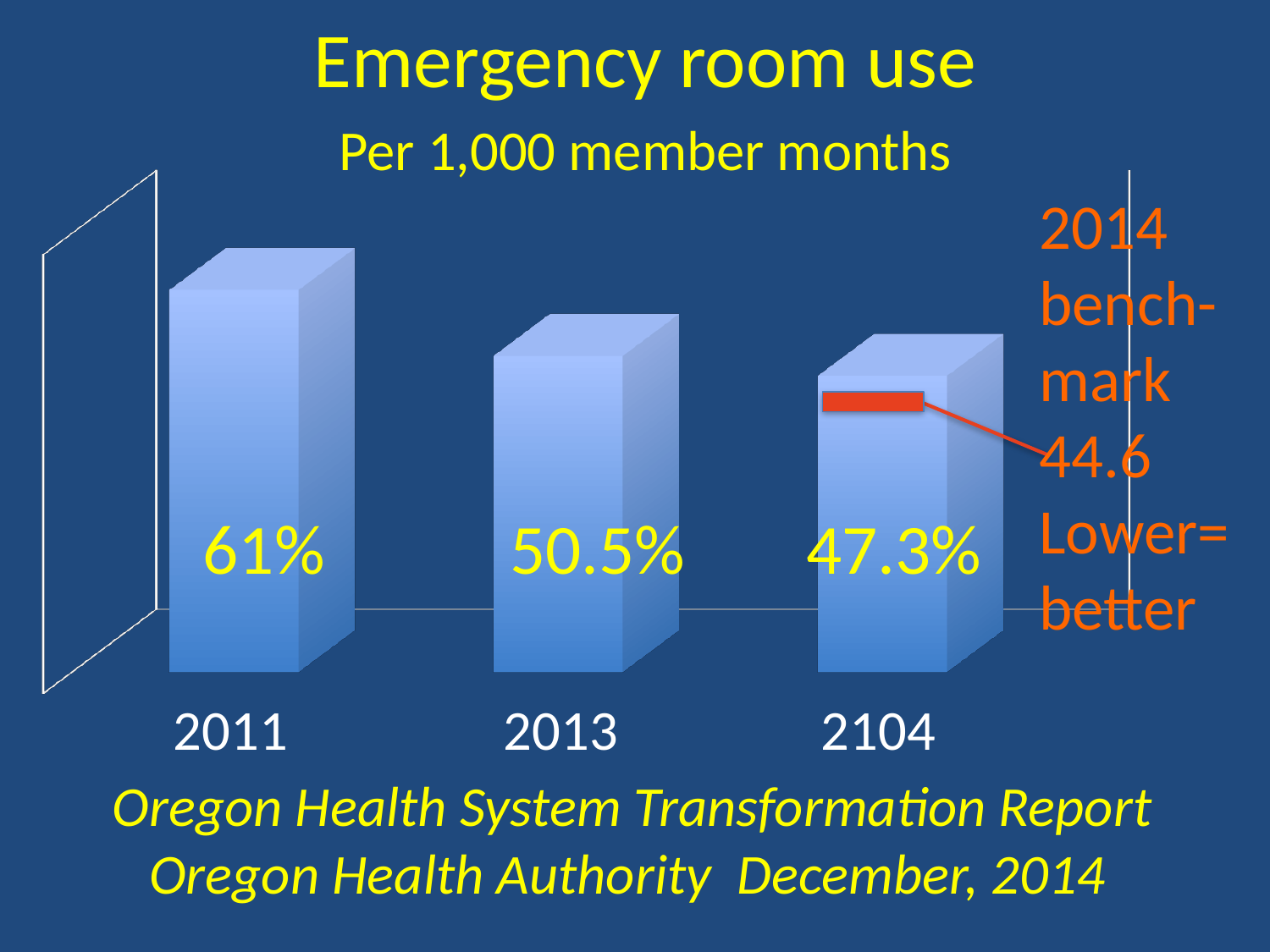
Which bar has the lowest value? 2104 How many bars are shown in the chart? 3 Do the values rise or fall from left to right across the bars? Fall Which year has the highest emergency room use? 2011 What is the difference between the 2011 value and the 2013 value? 10.5% What kind of chart is shown on the slide? Bar chart What is the value shown for 2013? 50.5% What is the difference between the 2013 value and the value for the bar labelled 2104? 3.2% Which is larger, the value for 2011 or the value for 2013? 2011 What is the value shown for the bar labelled 2104? 47.3% What is the 2014 benchmark value shown on the slide? 44.6 What is the value shown for 2011? 61%